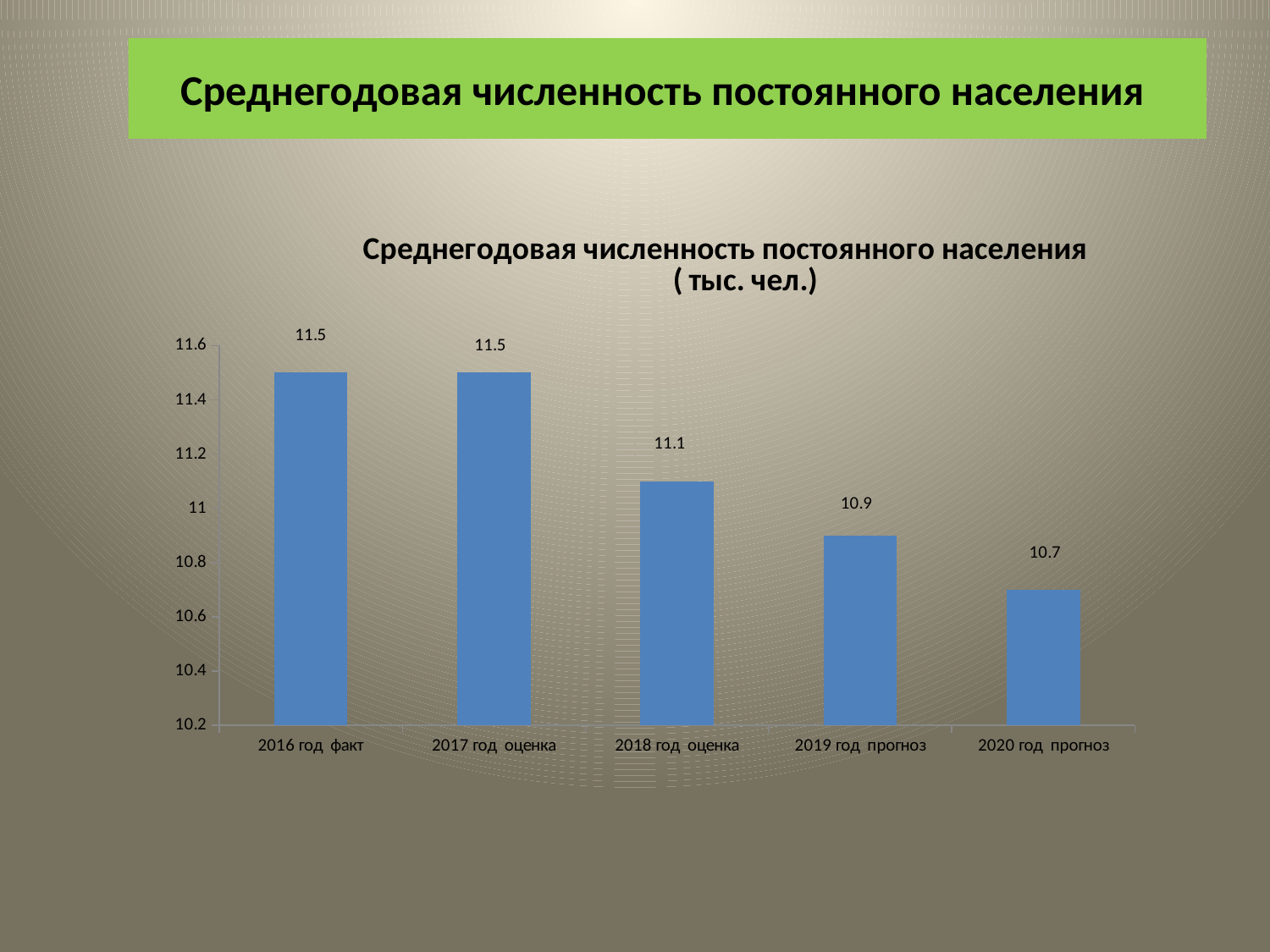
What is the difference between the values for 2016 год факт and 2020 год прогноз? 0.8 Which is larger, the value for 2017 год оценка or the value for 2018 год оценка? 2017 год оценка What is the value for 2018 год оценка? 11.1 Do the values rise or fall from 2016 год факт to 2020 год прогноз? fall What is the difference between the values for 2018 год оценка and 2019 год прогноз? 0.2 What kind of chart is shown on the slide? bar chart Which category has the lowest value? 2020 год прогноз What is the value for 2020 год прогноз? 10.7 Is the value for 2019 год прогноз greater or less than 11? less How many categories are shown on the x axis? 5 What is the value for 2019 год прогноз? 10.9 What unit is given in the chart title? тыс. чел.